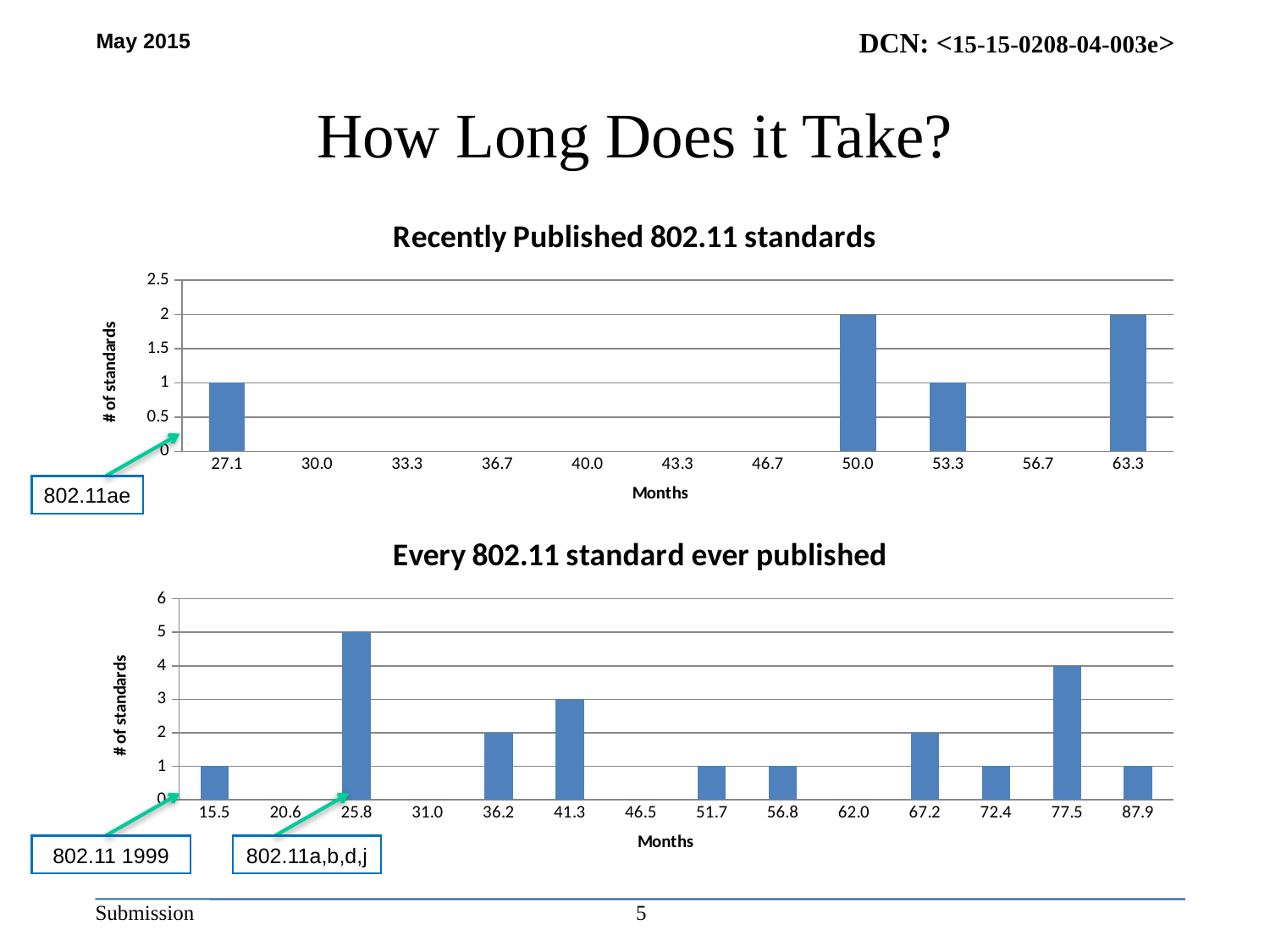
Which standard does the callout point to at the 27.1 month bar in the 'Recently Published 802.11 standards' chart? 802.11ae In the 'Every 802.11 standard ever published' chart, how many standards are shown for 25.8 months? 5 In the 'Every 802.11 standard ever published' chart, which is larger: the value for 36.2 months or the value for 41.3 months? 41.3 In the 'Every 802.11 standard ever published' chart, which month category has the highest number of standards? 25.8 What is the y-axis label of the 'Recently Published 802.11 standards' chart? # of standards In the 'Every 802.11 standard ever published' chart, what is the difference between the number of standards at 25.8 months and at 41.3 months? 2 In the 'Every 802.11 standard ever published' chart, how many month categories are on the x axis? 14 What type of chart is the 'Every 802.11 standard ever published' chart? bar chart In the 'Every 802.11 standard ever published' chart, how many standards are shown for 77.5 months? 4 In the 'Recently Published 802.11 standards' chart, how many standards are shown for 50.0 months? 2 In the 'Recently Published 802.11 standards' chart, how many month categories are on the x axis? 11 In the 'Recently Published 802.11 standards' chart, how many standards are shown for 53.3 months? 1